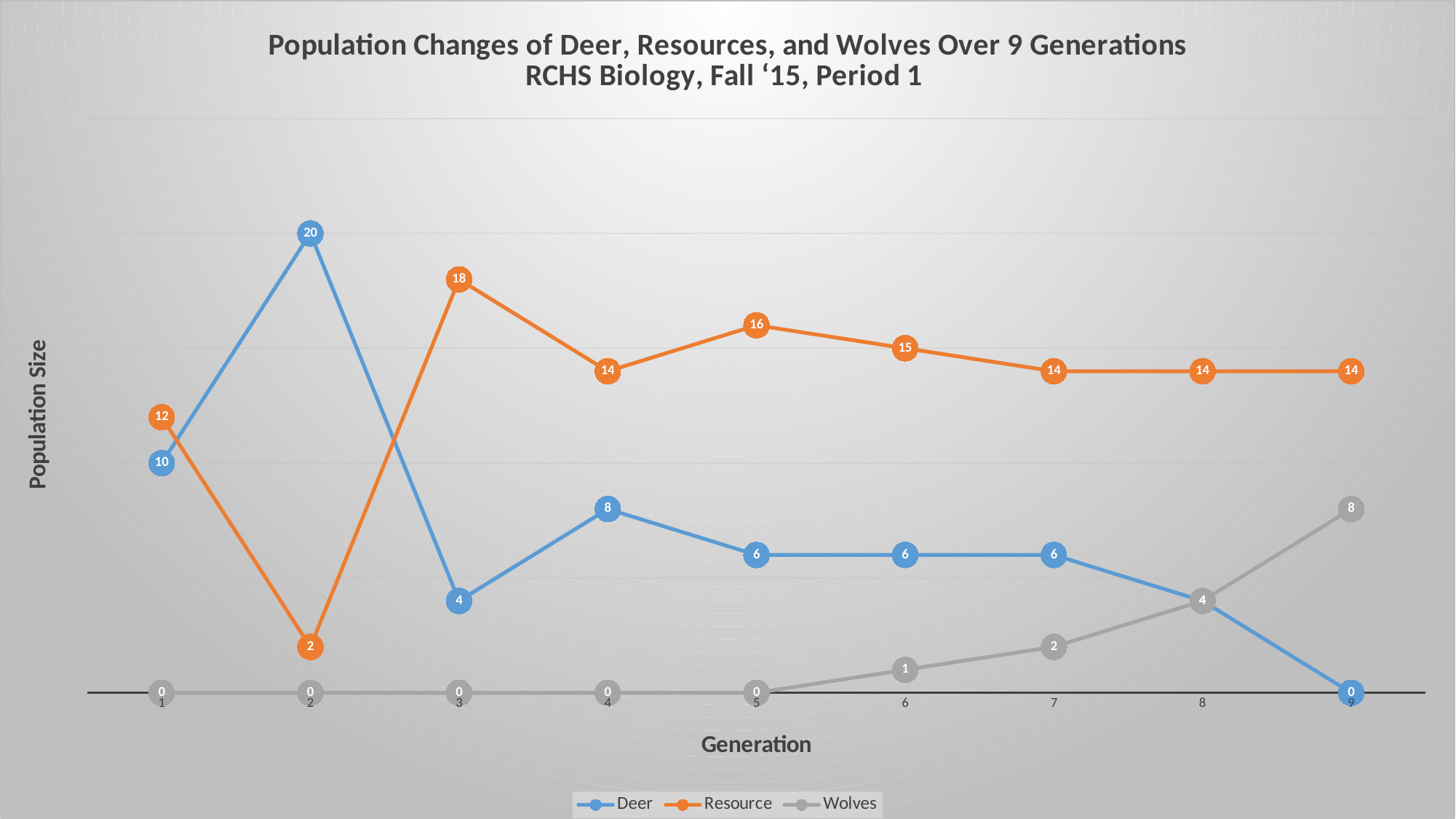
How many generations are plotted on the x axis? 9 What is the Wolves population in generation 9? 8 In which generation is the Deer population highest? 2 What kind of chart is shown on the slide? Line chart In which generation is the Resource value lowest? 2 What is the difference between the Resource value and the Deer population in generation 1? 2 What is the label of the y axis? Population Size Does the Wolves population rise or fall from generation 5 to generation 9? Rise How many series does the legend list? 3 What is the Deer population in generation 2? 20 What is the Resource value in generation 3? 18 In generation 4, which is larger, the Deer population or the Resource value? Resource